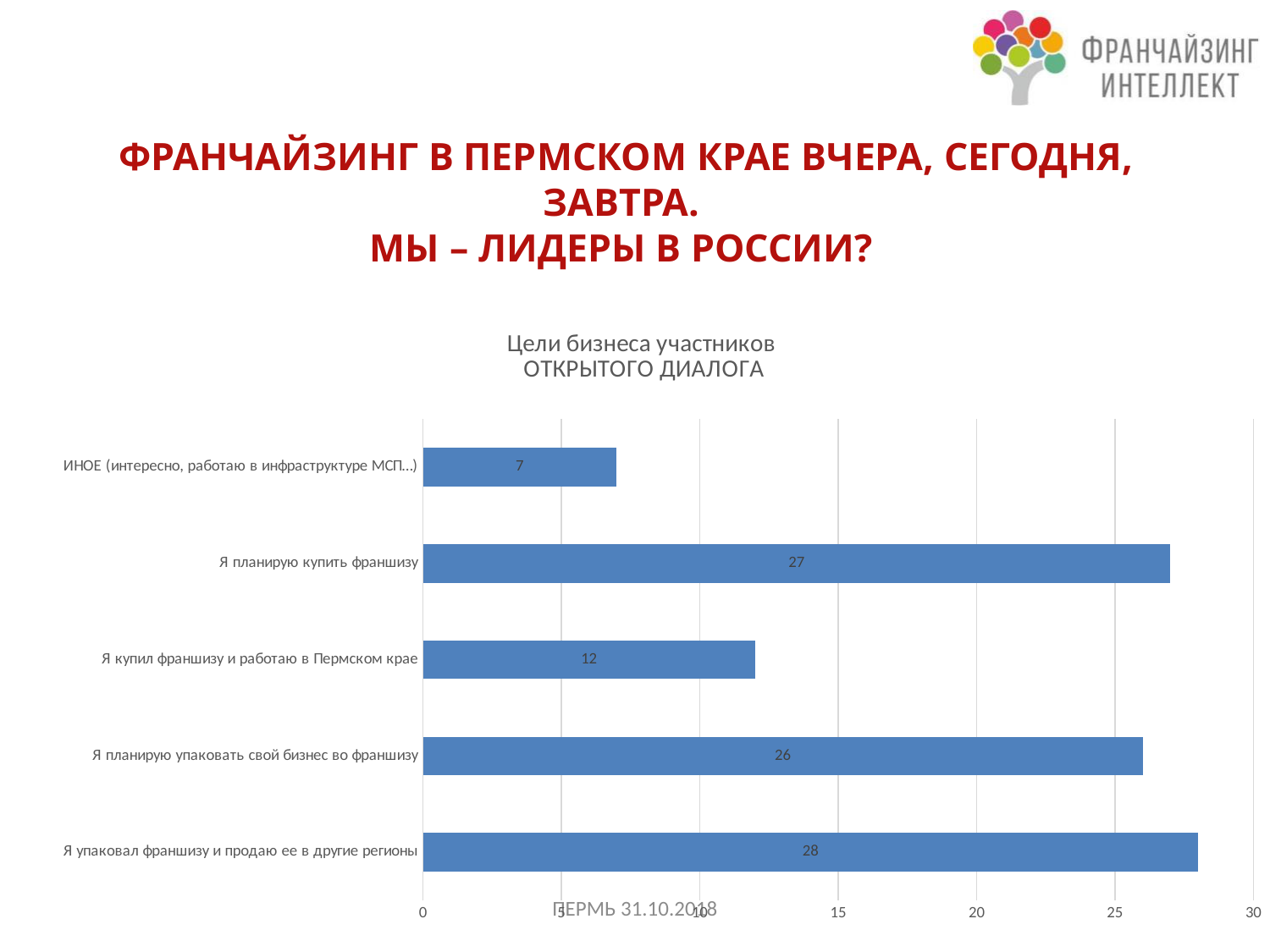
What is the value for "Я планирую купить франшизу"? 27 Which category has the highest value? Я упаковал франшизу и продаю ее в другие регионы Which category has the lowest value? ИНОЕ (интересно, работаю в инфраструктуре МСП…) Which is larger: the value for "Я планирую упаковать свой бизнес во франшизу" or the value for "Я купил франшизу и работаю в Пермском крае"? Я планирую упаковать свой бизнес во франшизу What kind of chart is shown on the slide? bar chart What is the difference between the values for "Я планирую купить франшизу" and "Я купил франшизу и работаю в Пермском крае"? 15 How many categories are shown in the chart? 5 Is the value for "Я планирую упаковать свой бизнес во франшизу" greater or less than 20? greater What is the value for "ИНОЕ (интересно, работаю в инфраструктуре МСП…)"? 7 What is the title of the chart? Цели бизнеса участников ОТКРЫТОГО ДИАЛОГА What is the value for "Я упаковал франшизу и продаю ее в другие регионы"? 28 What is the value for "Я купил франшизу и работаю в Пермском крае"? 12